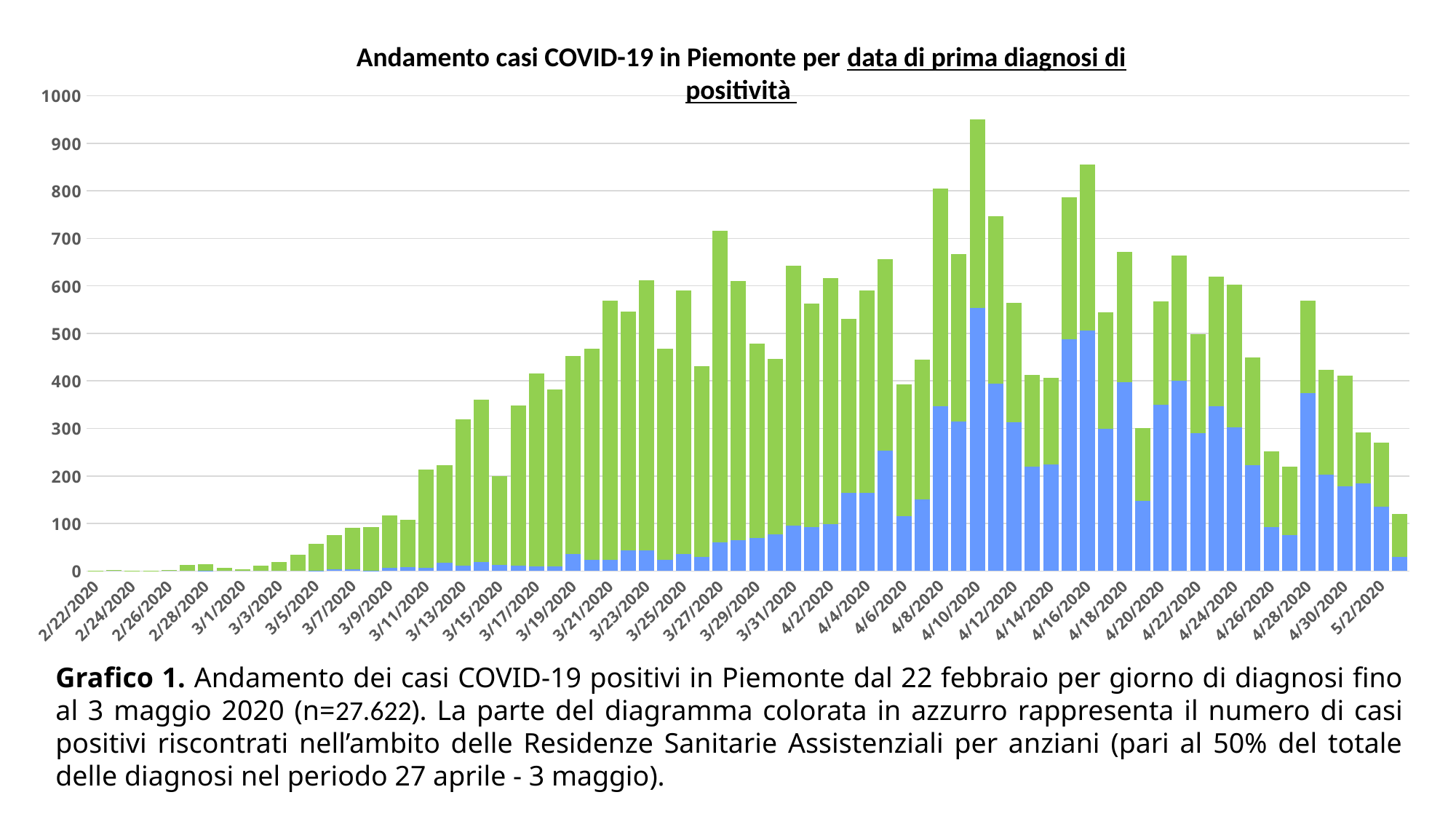
Is the total value for 5/2/2020 greater or less than 200? greater Which date has the taller bar, 4/10/2020 or 4/16/2020? 4/10/2020 Which date has the taller bar, 3/27/2020 or 3/29/2020? 3/27/2020 Is the total value for 4/10/2020 greater or less than 900? greater Is the total value for 4/16/2020 greater or less than 800? greater Which date has the tallest bar in the chart? 4/10/2020 Do the bar totals generally rise or fall from 2/22/2020 to 4/10/2020? rise What is the highest value shown on the vertical axis? 1000 What colour represents the cases found in the Residenze Sanitarie Assistenziali (RSA)? azzurro (blue) What kind of chart is shown on the slide? bar chart